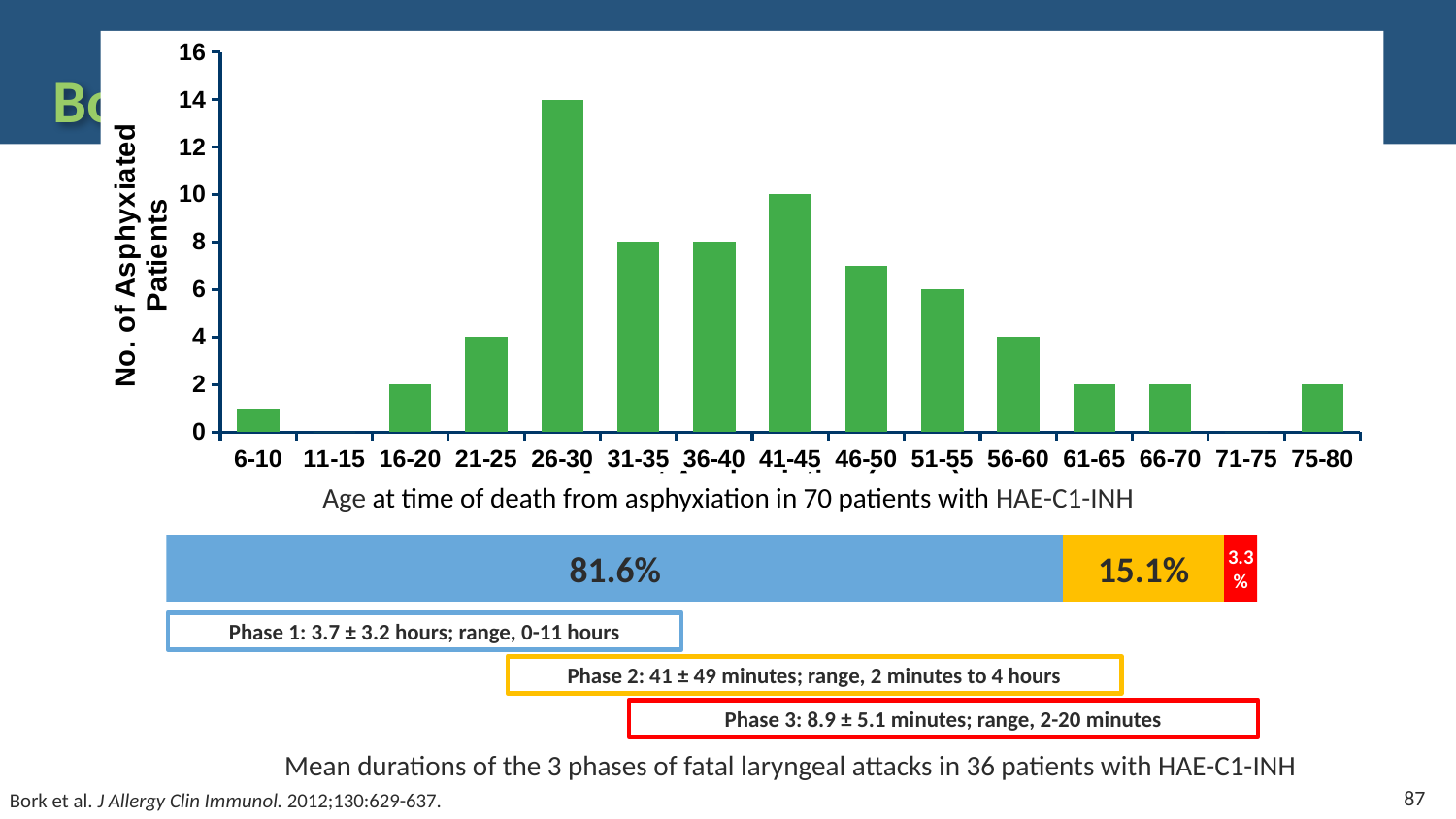
In the bar chart of age at time of death from asphyxiation, how many age groups are shown on the x axis? 15 In the stacked bar showing the 3 phases of fatal laryngeal attacks, which phase has the smallest share? Phase 3 (3.3%) In the bar chart of age at time of death from asphyxiation, how many asphyxiated patients are in the 41-45 age group? 10 In the stacked bar showing the 3 phases of fatal laryngeal attacks, what is the difference between the Phase 1 share (81.6%) and the Phase 2 share (15.1%)? 66.5% In the bar chart of age at time of death from asphyxiation, what kind of chart is shown? bar chart In the bar chart of age at time of death from asphyxiation, which age group has the highest number of asphyxiated patients? 26-30 In the bar chart of age at time of death from asphyxiation, is the value for the 6-10 age group greater or less than 2? less In the bar chart of age at time of death from asphyxiation, how many asphyxiated patients are in the 26-30 age group? 14 In the bar chart of age at time of death from asphyxiation, how many asphyxiated patients are in the 51-55 age group? 6 In the stacked bar showing the 3 phases of fatal laryngeal attacks, what percentage does the blue segment (Phase 1) represent? 81.6% In the bar chart of age at time of death from asphyxiation, which has more asphyxiated patients, the 41-45 group or the 31-35 group? 41-45 In the bar chart of age at time of death from asphyxiation, is the value for the 46-50 age group greater or less than 6? greater